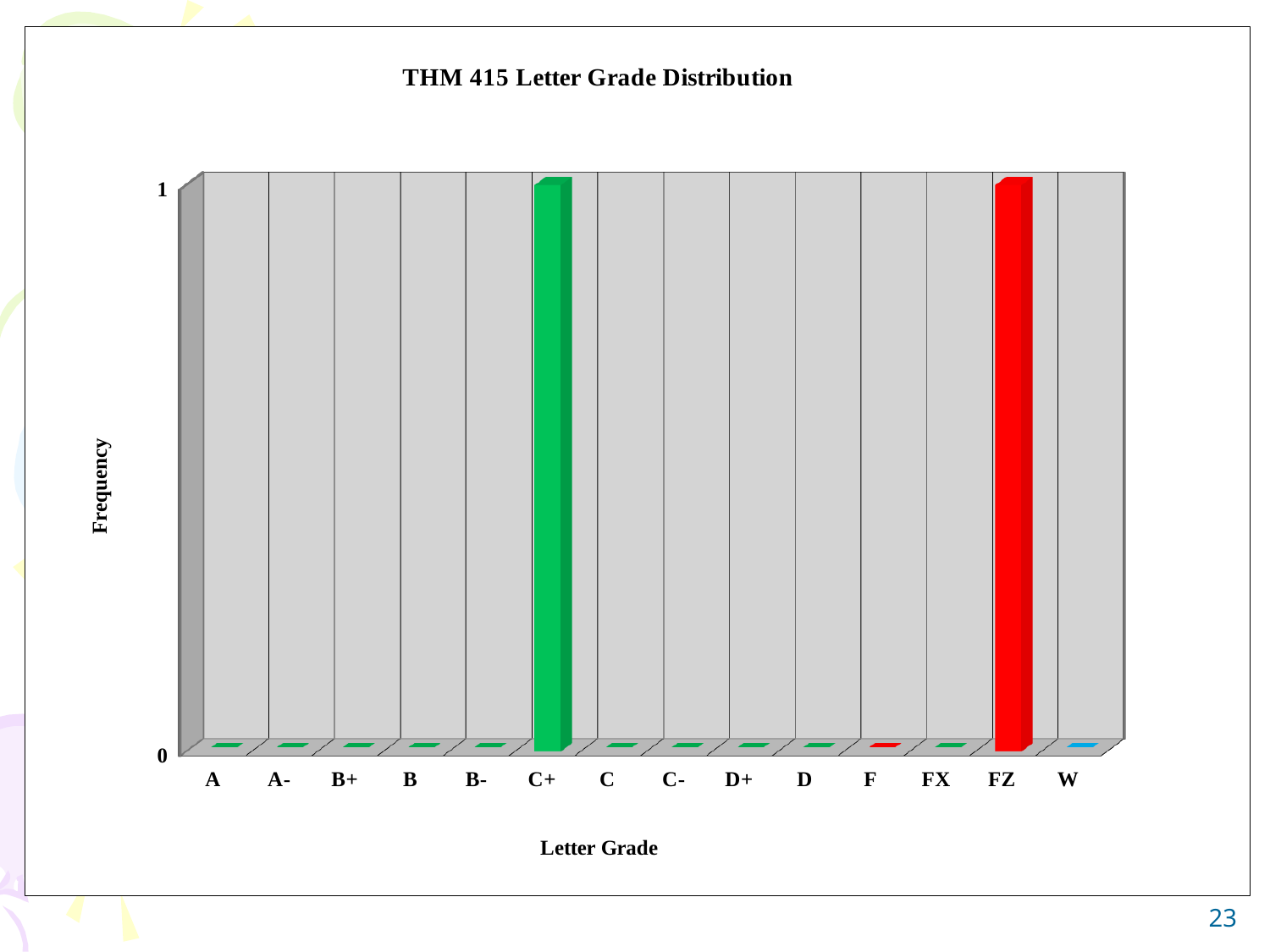
What is the frequency for the C+ letter grade? 1 How many letter grade categories are shown on the x axis? 14 What is the frequency for the FZ letter grade? 1 Which letter grades have the highest frequency? C+ and FZ Which has a higher frequency, C+ or B? C+ What is the frequency for the W letter grade? 0 What is the difference between the frequency for C+ and the frequency for D? 1 What is the frequency for the A letter grade? 0 Which has a higher frequency, FZ or F? FZ What type of chart is shown on the slide? bar chart What is the label of the y axis? Frequency What is the title of the chart? THM 415 Letter Grade Distribution